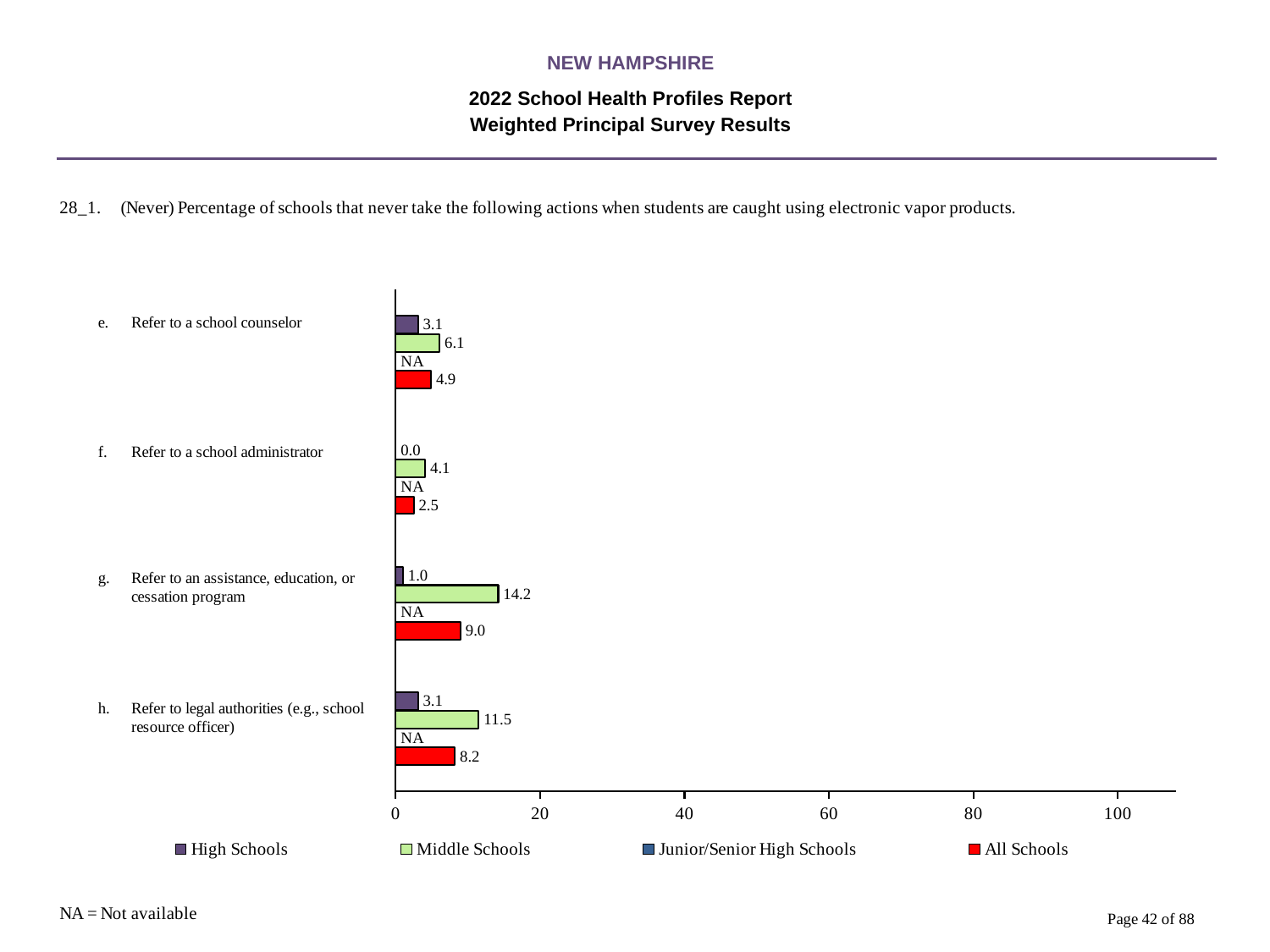
What is the All Schools value for 'Refer to a school counselor'? 4.9 What is the High Schools value for 'Refer to a school administrator'? 0.0 How many actions (categories) are shown on the chart? 4 What is the All Schools value for 'Refer to legal authorities (e.g., school resource officer)'? 8.2 Which action has the lowest All Schools value? Refer to a school administrator How many series does the legend list? 4 What is the difference between the Middle Schools and High Schools values for 'Refer to legal authorities (e.g., school resource officer)'? 8.4 Which is larger for 'Refer to a school counselor': the Middle Schools value or the All Schools value? Middle Schools Is the Middle Schools value for 'Refer to an assistance, education, or cessation program' greater or less than 20? less Which action has the highest Middle Schools value? Refer to an assistance, education, or cessation program What kind of chart is shown on the slide? bar chart What is the Middle Schools value for 'Refer to an assistance, education, or cessation program'? 14.2